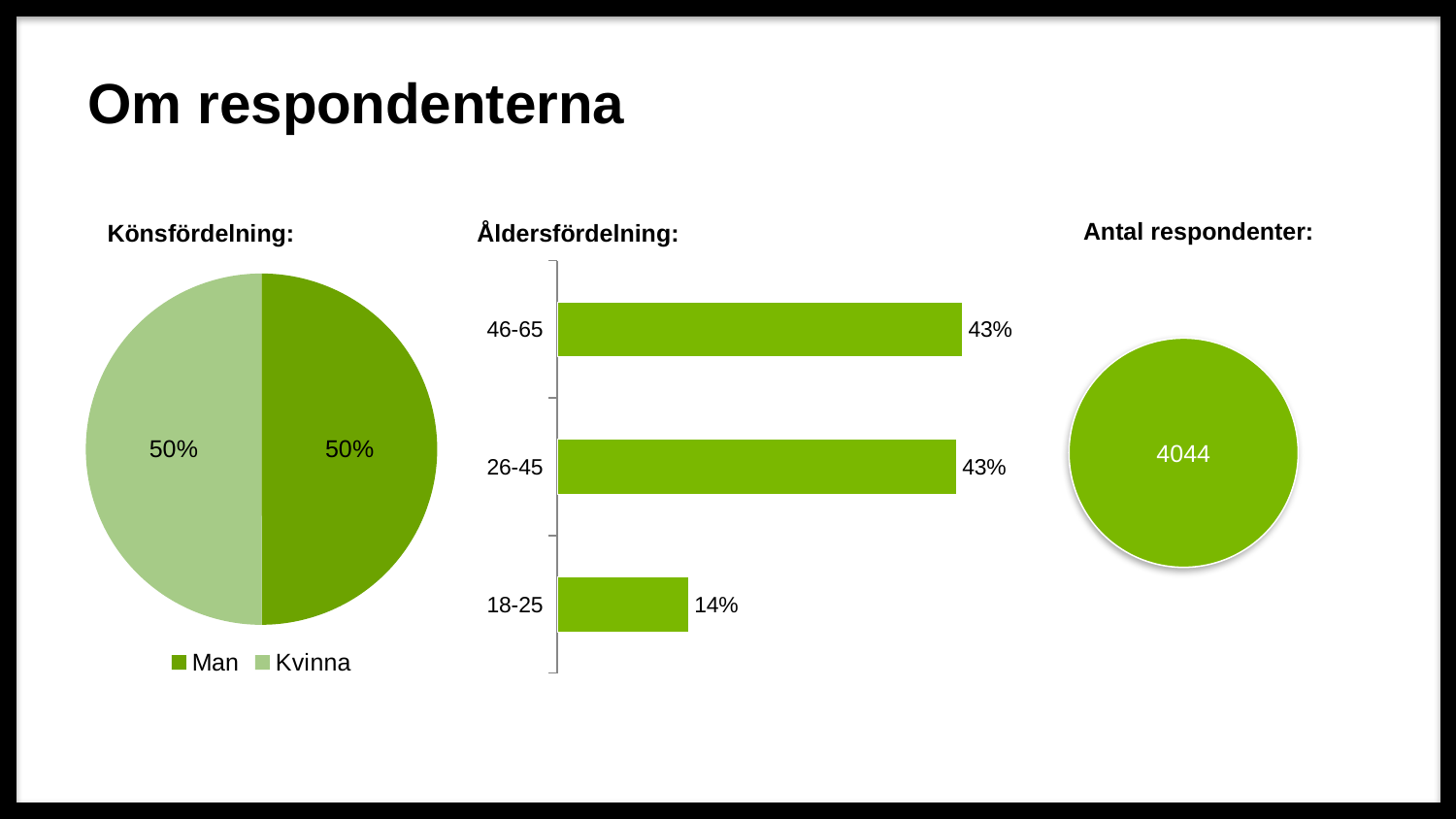
In the Åldersfördelning chart, what is the difference between the values for 26-45 and 18-25? 29% In the Könsfördelning chart, what share of respondents are Man? 50% In the Åldersfördelning chart, which is larger, the value for 46-65 or the value for 18-25? 46-65 In the Åldersfördelning chart, what is the value for 26-45? 43% In the Åldersfördelning chart, what is the value for 18-25? 14% In the Könsfördelning chart, what share of respondents are Kvinna? 50% In the Åldersfördelning chart, what is the value for 46-65? 43% What kind of chart is the Könsfördelning chart? Pie chart How many age groups are shown in the Åldersfördelning chart? 3 What kind of chart is the Åldersfördelning chart? Bar chart How many entries does the legend of the Könsfördelning chart list? 2 In the Åldersfördelning chart, which age group has the lowest value? 18-25